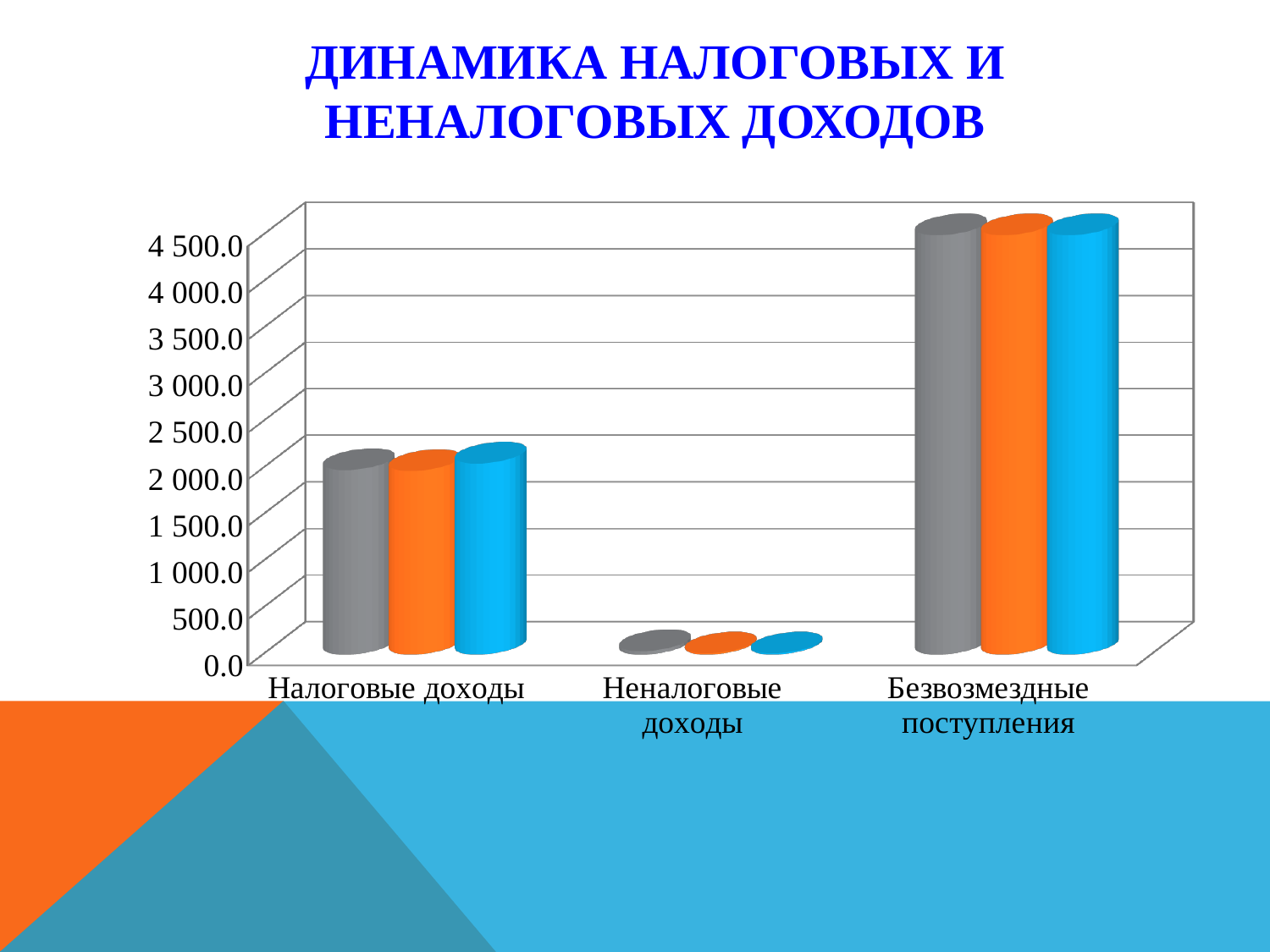
What is the title of the slide containing the chart? ДИНАМИКА НАЛОГОВЫХ И НЕНАЛОГОВЫХ ДОХОДОВ Are the values for Налоговые доходы greater or less than 1 500.0? greater Which category has larger values: Налоговые доходы or Неналоговые доходы? Налоговые доходы Are the values for Налоговые доходы greater or less than 2 500.0? less How many bars are shown for each category in the chart? 3 What kind of chart is shown on the slide? bar chart Are the values for Неналоговые доходы greater or less than 500.0? less Which category has the lowest values in the chart? Неналоговые доходы Which category has the highest values in the chart? Безвозмездные поступления How many categories are shown on the x axis of the chart? 3 Which category has larger values: Безвозмездные поступления or Налоговые доходы? Безвозмездные поступления